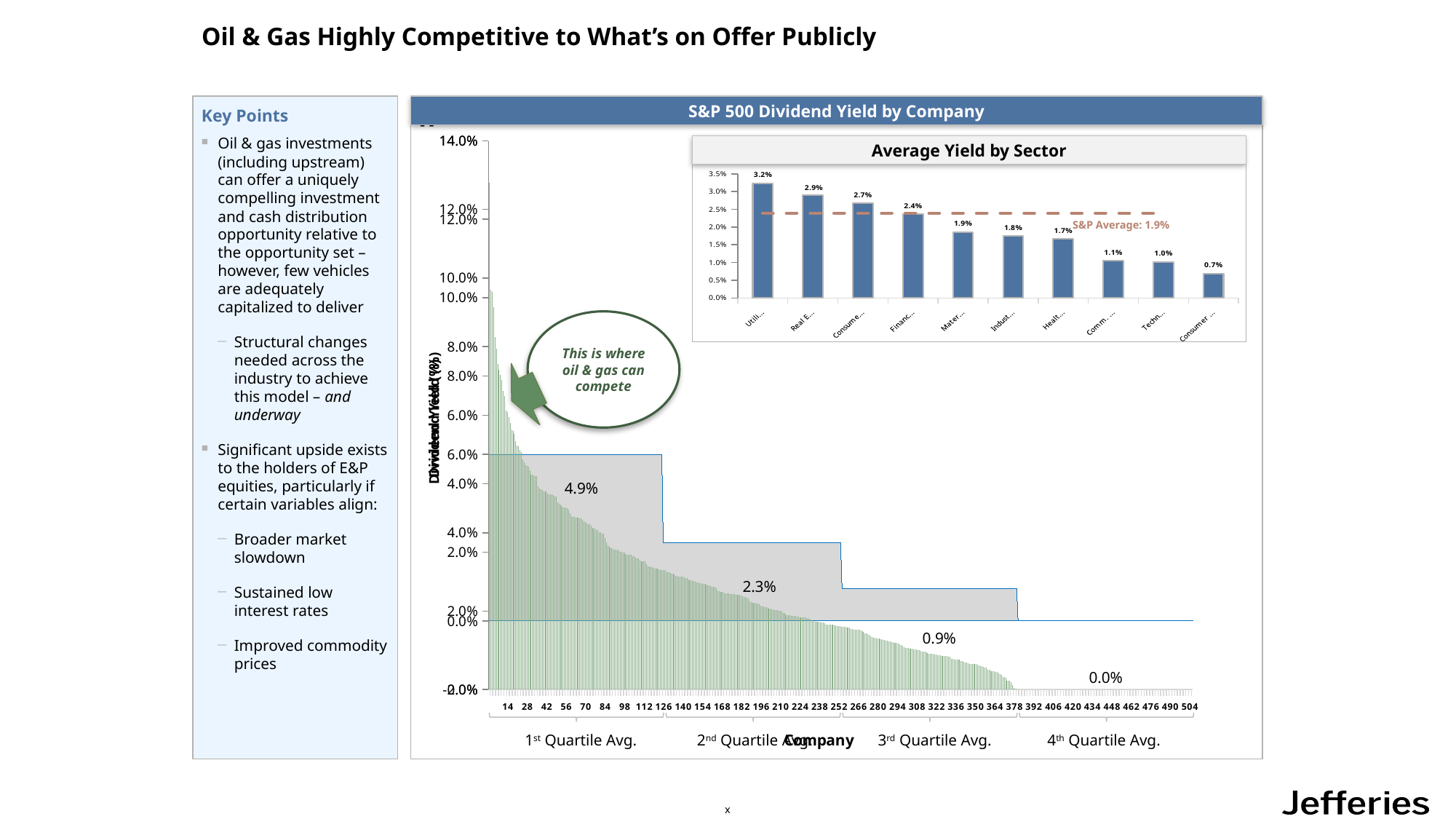
In the 'Average Yield by Sector' chart, what is the highest value shown? 3.2% In the 'S&P 500 Dividend Yield by Company' chart, what is the difference between the 1st Quartile Avg. and the 2nd Quartile Avg.? 2.6% In the 'S&P 500 Dividend Yield by Company' chart, what is the 3rd Quartile Avg.? 0.9% What kind of chart is the 'Average Yield by Sector' chart? Bar chart In the 'Average Yield by Sector' chart, what is the S&P Average marked by the dashed line? 1.9% How many bars are plotted in the 'Average Yield by Sector' chart? 10 In the 'S&P 500 Dividend Yield by Company' chart, do the dividend yields rise or fall from left to right along the x axis? Fall In the 'Average Yield by Sector' chart, what is the difference between the highest and lowest bar values? 2.5% In the 'S&P 500 Dividend Yield by Company' chart, what is the 1st Quartile Avg.? 4.9% In the 'S&P 500 Dividend Yield by Company' chart, what is the 2nd Quartile Avg.? 2.3% In the 'S&P 500 Dividend Yield by Company' chart, what is the 4th Quartile Avg.? 0.0% In the 'Average Yield by Sector' chart, what is the lowest value shown? 0.7%